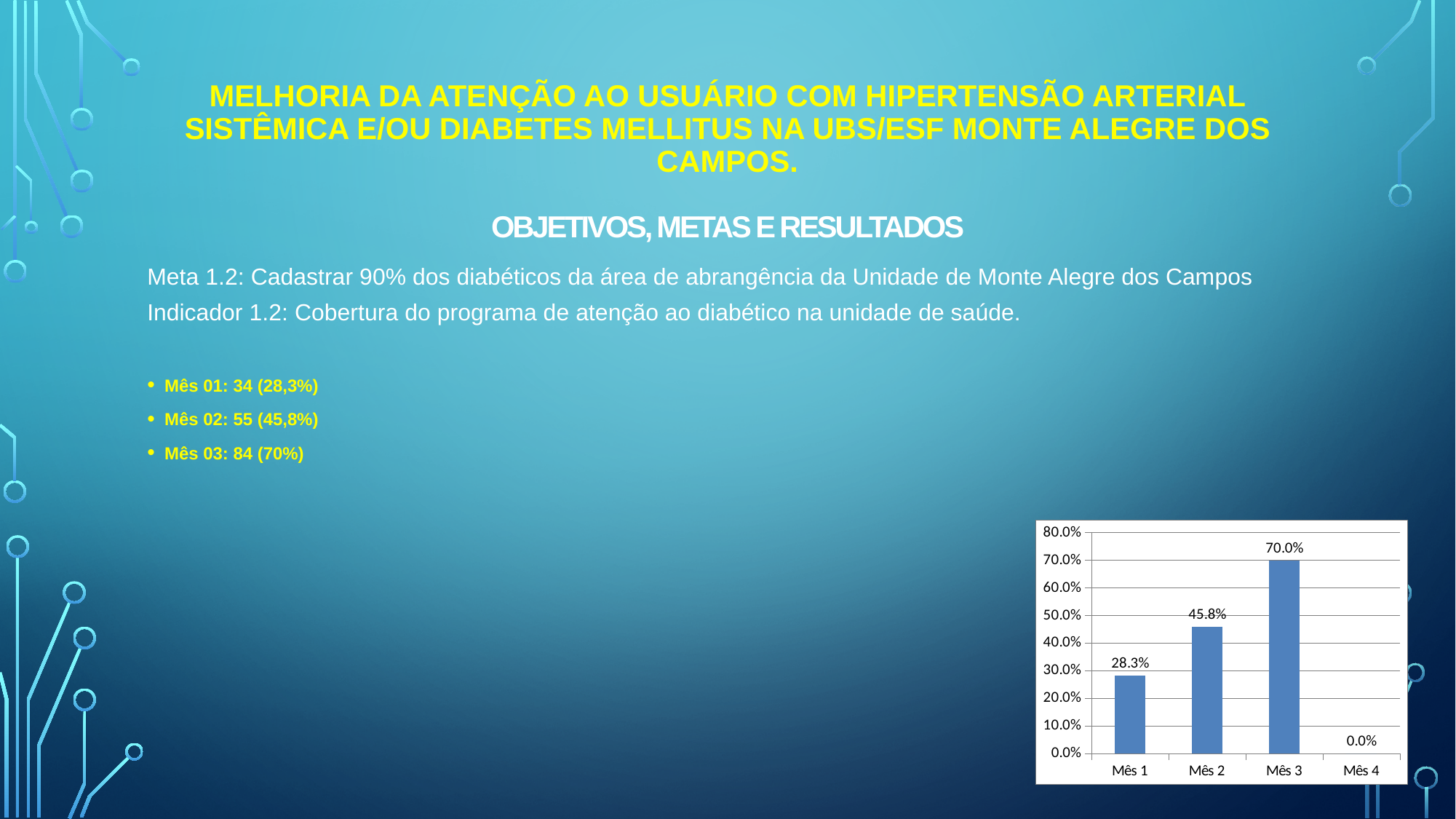
Which category has the highest value in the chart? Mês 3 Do the values rise or fall from Mês 1 to Mês 3? Rise What is the value for Mês 3 in the chart? 70.0% What is the value for Mês 2 in the chart? 45.8% What is the difference between the values for Mês 3 and Mês 2? 24.2% What is the value for Mês 4 in the chart? 0.0% Which category has the lowest value in the chart? Mês 4 What kind of chart is shown on the slide? Bar chart Which is larger, the value for Mês 1 or the value for Mês 2? Mês 2 What is the difference between the values for Mês 2 and Mês 1? 17.5% What is the value for Mês 1 in the chart? 28.3% How many categories are shown on the x axis of the chart? 4